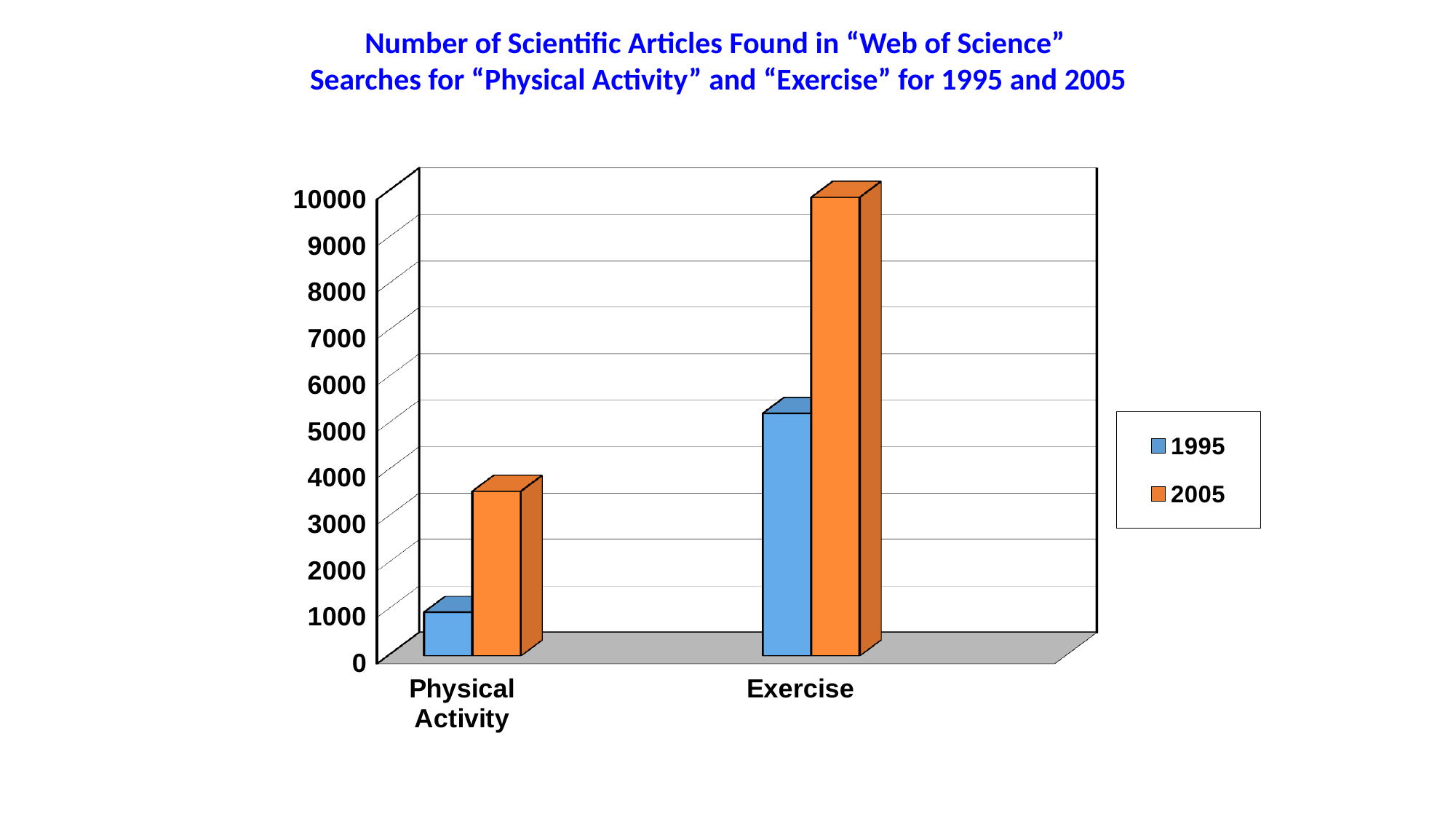
How many categories are shown on the x axis? 2 How many series does the legend list? 2 Is the 2005 value for Physical Activity greater or less than 3000? greater Is the 1995 value for Exercise greater or less than 4000? greater Which is larger: the 2005 value for Exercise or the 2005 value for Physical Activity? Exercise Which category and series has the tallest bar? Exercise, 2005 Which series are listed in the legend? 1995 and 2005 Which category and series has the shortest bar? Physical Activity, 1995 Is the 2005 value for Physical Activity greater or less than 4000? less What kind of chart is shown on the slide? bar chart Which is larger: the 1995 value for Exercise or the 1995 value for Physical Activity? Exercise